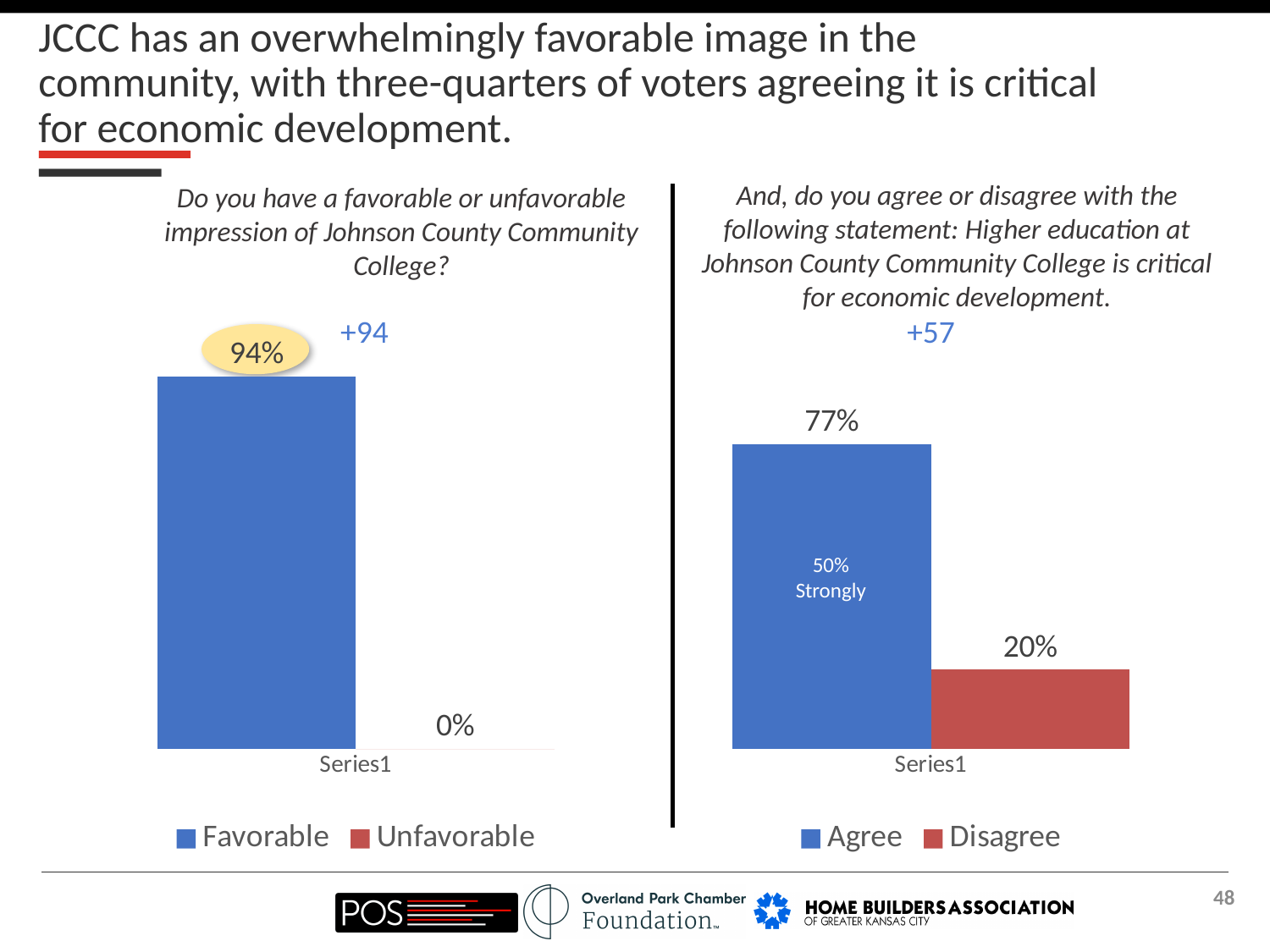
In the left chart on favorable or unfavorable impression of Johnson County Community College, what percentage is Unfavorable? 0% In the left chart on favorable or unfavorable impression of Johnson County Community College, what percentage is Favorable? 94% In the right chart on whether higher education at JCCC is critical for economic development, which is larger, Agree or Disagree? Agree How many series does the legend of the right chart on whether higher education at JCCC is critical for economic development list? 2 What net figure is shown above the left chart on favorable or unfavorable impression of Johnson County Community College? +94 In the right chart on whether higher education at JCCC is critical for economic development, what percentage Strongly agree? 50% In the left chart on favorable or unfavorable impression of Johnson County Community College, what is the difference between Favorable and Unfavorable? 94 percentage points What kind of chart is the left chart on favorable or unfavorable impression of Johnson County Community College? Bar chart In the right chart on whether higher education at JCCC is critical for economic development, what percentage Agree? 77% In the right chart on whether higher education at JCCC is critical for economic development, what percentage Disagree? 20% In the right chart on whether higher education at JCCC is critical for economic development, what is the difference between Agree and Disagree? 57 percentage points In the left chart on favorable or unfavorable impression of Johnson County Community College, which series is highest? Favorable